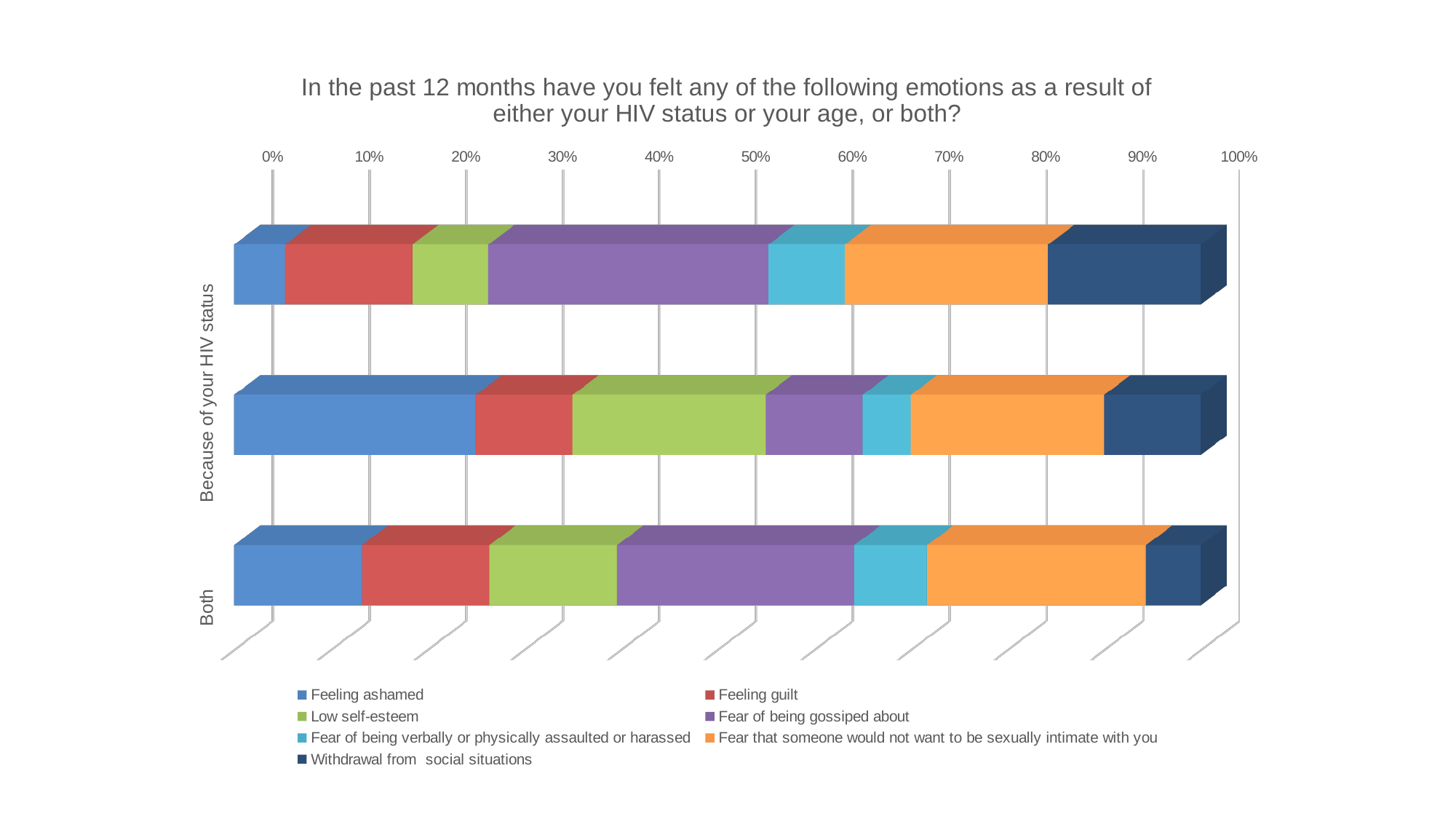
In the 'Because of your HIV status' bar, is the 'Feeling ashamed' segment greater or less than 10%? less In the 'Because of your HIV status' bar, is the 'Fear of being gossiped about' segment greater or less than 20%? greater In the 'Both' bar, which segment is larger: 'Fear of being gossiped about' or 'Low self-esteem'? Fear of being gossiped about Which emotion has the largest segment in the 'Because of your HIV status' bar? Fear of being gossiped about How many series does the legend list? 7 What kind of chart is shown on the slide? Stacked bar chart In the 'Both' bar, is the 'Feeling ashamed' segment greater or less than 20%? less How many stacked bars are plotted in the chart? 3 Is the 'Feeling ashamed' segment larger in the 'Both' bar or in the 'Because of your HIV status' bar? Both Which emotion has the smallest segment in the 'Because of your HIV status' bar? Feeling ashamed Which colour represents 'Withdrawal from social situations' in the legend? Dark blue